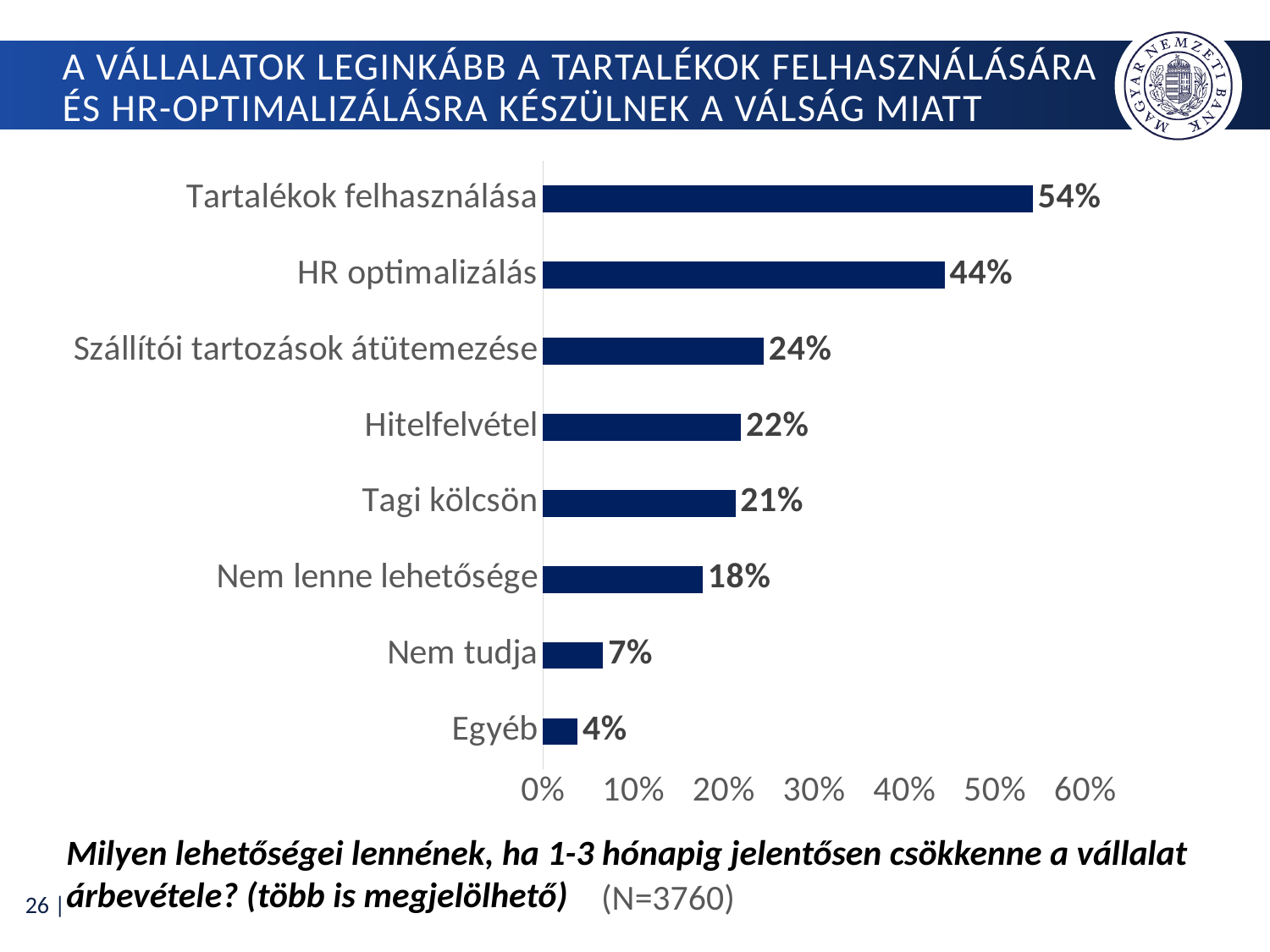
What is the value for Nem tudja? 7% Which category has the lowest value? Egyéb What is the difference between the values for Tartalékok felhasználása and HR optimalizálás? 10% What is the value for Hitelfelvétel? 22% Is the value for HR optimalizálás greater or less than 40%? greater What kind of chart is shown on the slide? bar chart Which is larger, the value for Tagi kölcsön or the value for Nem lenne lehetősége? Tagi kölcsön What is the sample size (N) stated below the chart? N=3760 How many categories are shown in the chart? 8 Which category has the highest value? Tartalékok felhasználása What is the value for Tartalékok felhasználása? 54% What is the difference between the values for Szállítói tartozások átütemezése and Nem lenne lehetősége? 6%